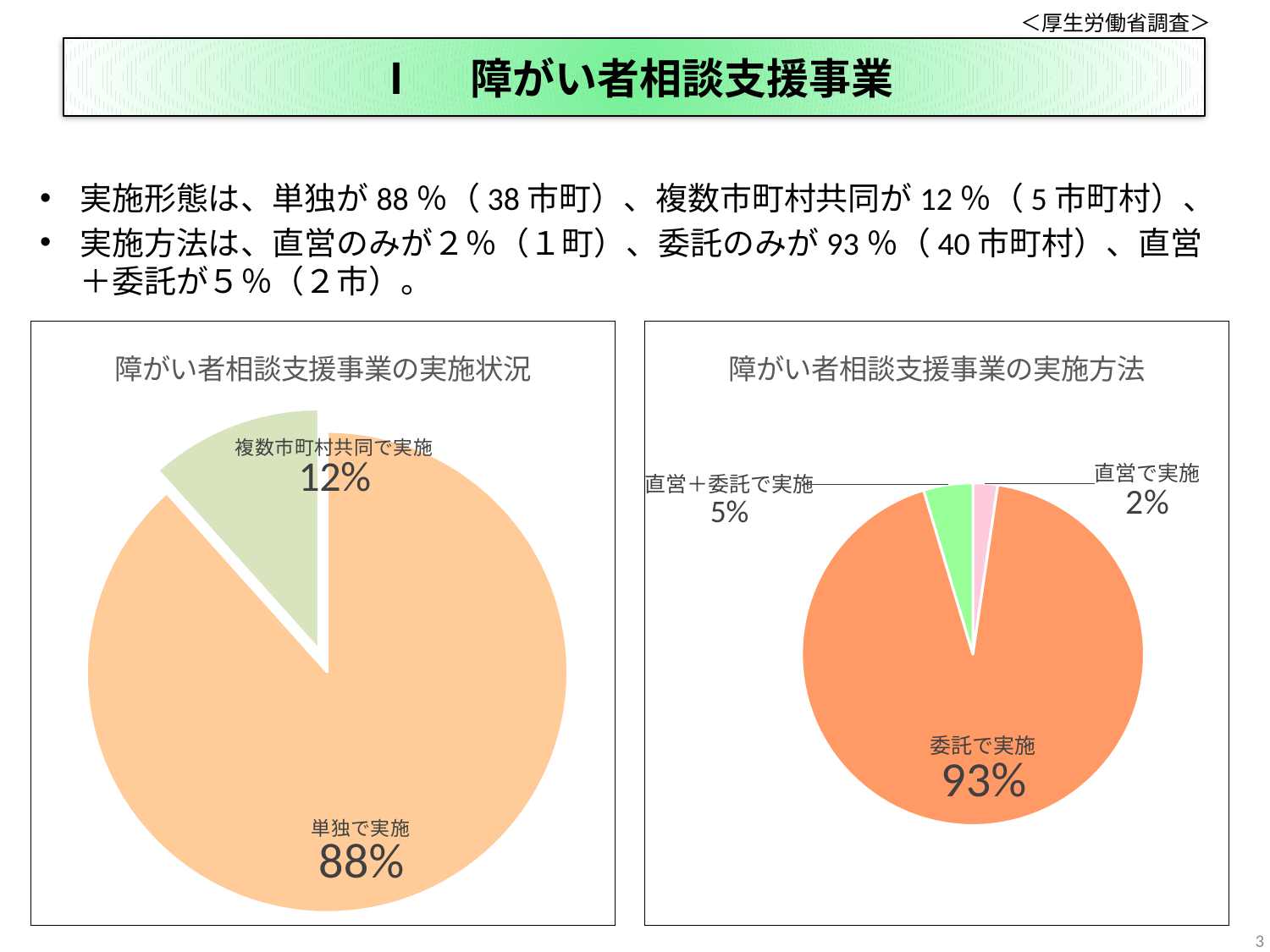
In the chart titled 障がい者相談支援事業の実施方法, which slice is the smallest? 直営で実施 In the chart titled 障がい者相談支援事業の実施状況, what share of the pie is 複数市町村共同で実施? 12% In the chart titled 障がい者相談支援事業の実施状況, what share of the pie is 単独で実施? 88% What kind of chart is the chart titled 障がい者相談支援事業の実施方法? Pie chart In the chart titled 障がい者相談支援事業の実施状況, how many slices does the pie have? 2 In the chart titled 障がい者相談支援事業の実施状況, what is the difference between the 単独で実施 and 複数市町村共同で実施 shares? 76% In the chart titled 障がい者相談支援事業の実施方法, what share of the pie is 直営で実施? 2% In the chart titled 障がい者相談支援事業の実施状況, which slice is the largest? 単独で実施 In the chart titled 障がい者相談支援事業の実施方法, how many slices does the pie have? 3 In the chart titled 障がい者相談支援事業の実施方法, which is larger, 直営＋委託で実施 or 直営で実施? 直営＋委託で実施